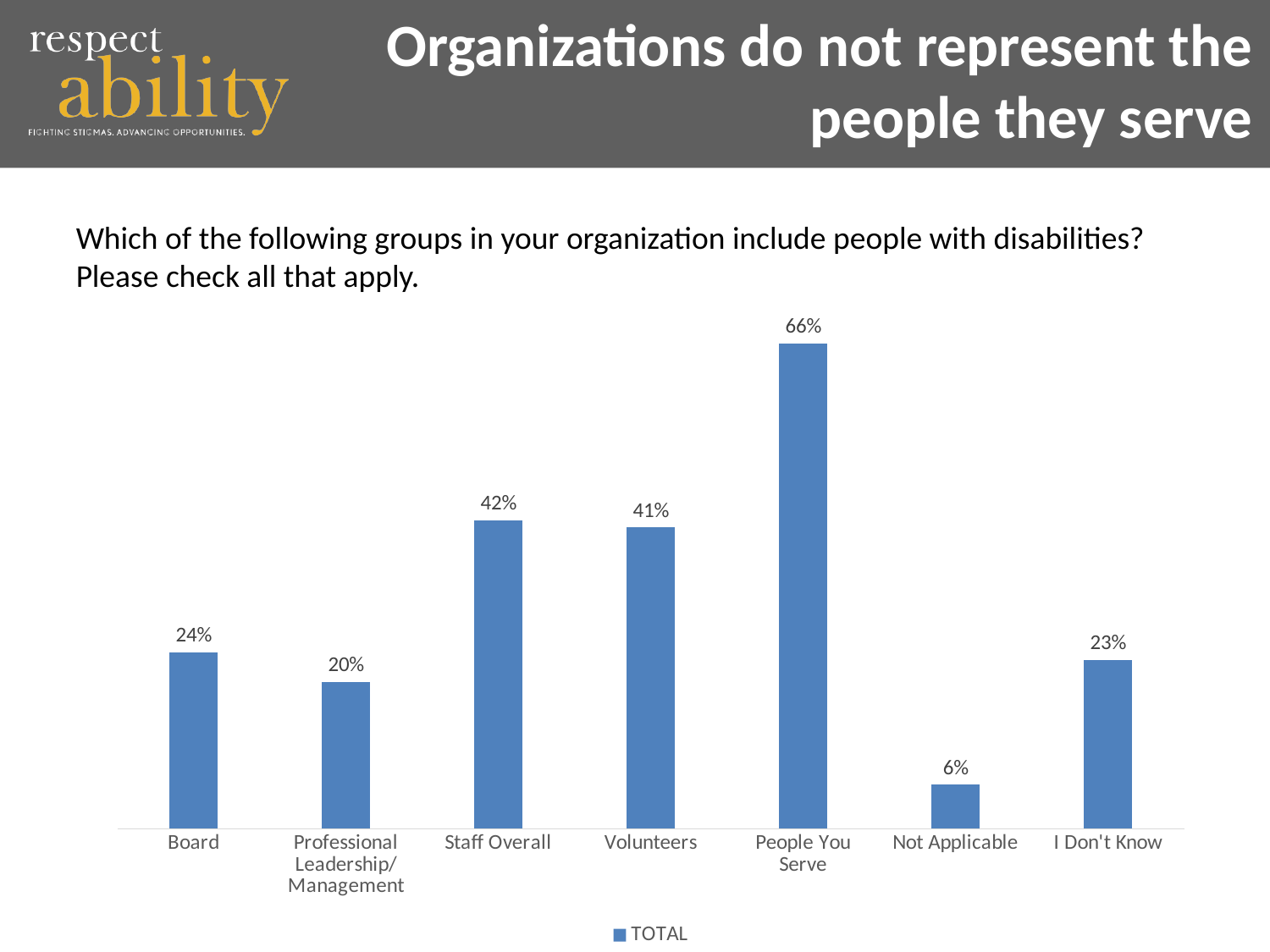
What is the difference between the values for Board and Not Applicable? 18% What is the value for Board? 24% Which category has the highest value? People You Serve What percentage is shown for People You Serve? 66% What percentage is shown for Professional Leadership/Management? 20% What is the value for I Don't Know? 23% What series name does the legend show? TOTAL What kind of chart is shown on the slide? Bar chart Which is larger, the value for Board or the value for Professional Leadership/Management? Board How many categories are shown on the x axis? 7 Which category has the lowest value? Not Applicable What is the difference between the values for People You Serve and Staff Overall? 24%